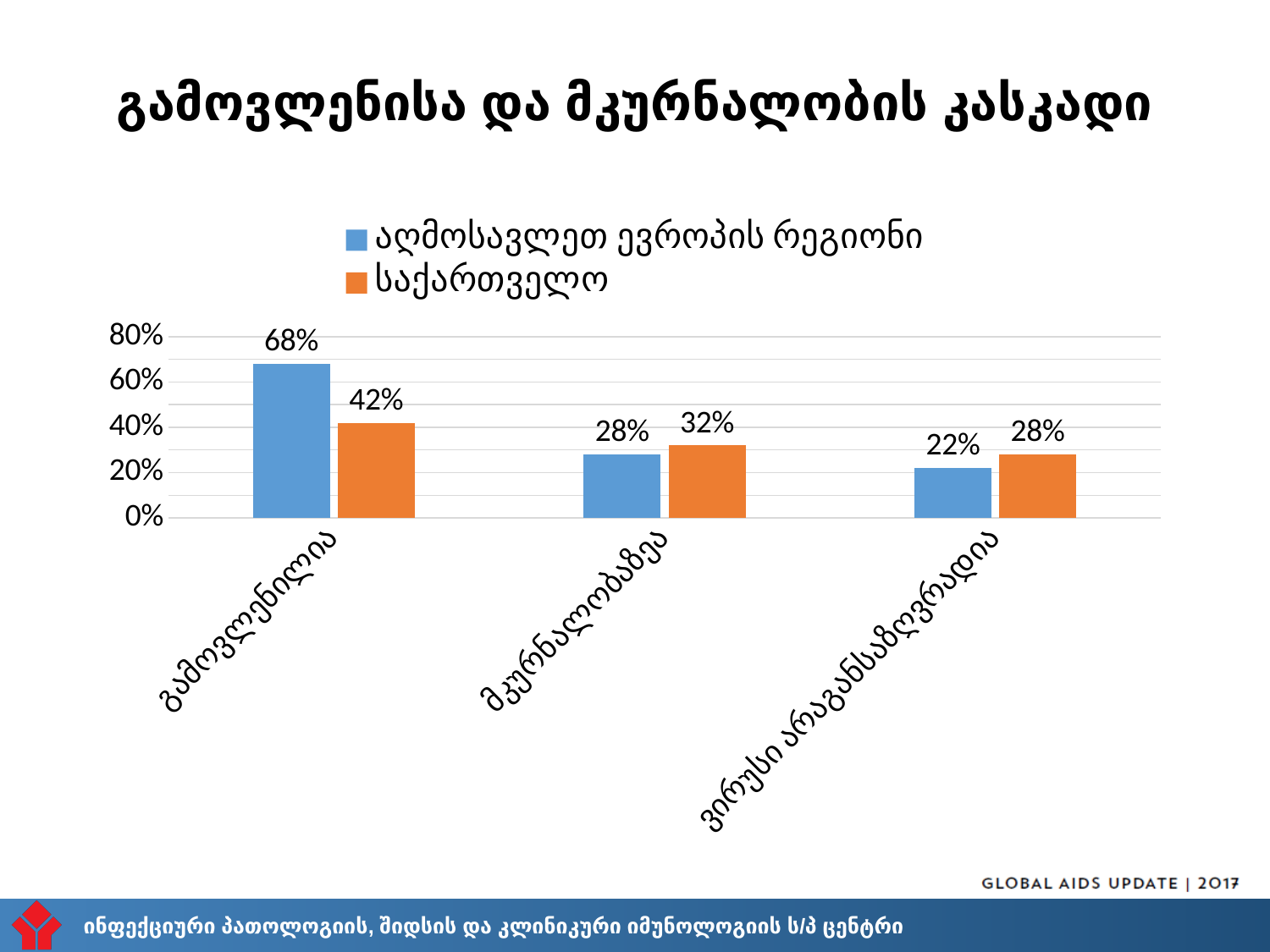
How many series does the legend list? 2 How many categories are shown on the x axis? 3 Which category has the lowest value for საქართველო? ვირუსი არაგანსაზღვრადია What is the value for აღმოსავლეთ ევროპის რეგიონი in the გამოვლენილია category? 68% Do the values for აღმოსავლეთ ევროპის რეგიონი rise or fall from left to right along the x axis? Fall What is the value for საქართველო in the გამოვლენილია category? 42% What is the value for საქართველო in the მკურნალობაზეა category? 32% What is the difference between აღმოსავლეთ ევროპის რეგიონი and საქართველო in the გამოვლენილია category? 26% In the მკურნალობაზეა category, which series has the larger value: აღმოსავლეთ ევროპის რეგიონი or საქართველო? საქართველო Which category has the highest value for აღმოსავლეთ ევროპის რეგიონი? გამოვლენილია What is the value for აღმოსავლეთ ევროპის რეგიონი in the ვირუსი არაგანსაზღვრადია category? 22% What kind of chart is shown on the slide? Bar chart